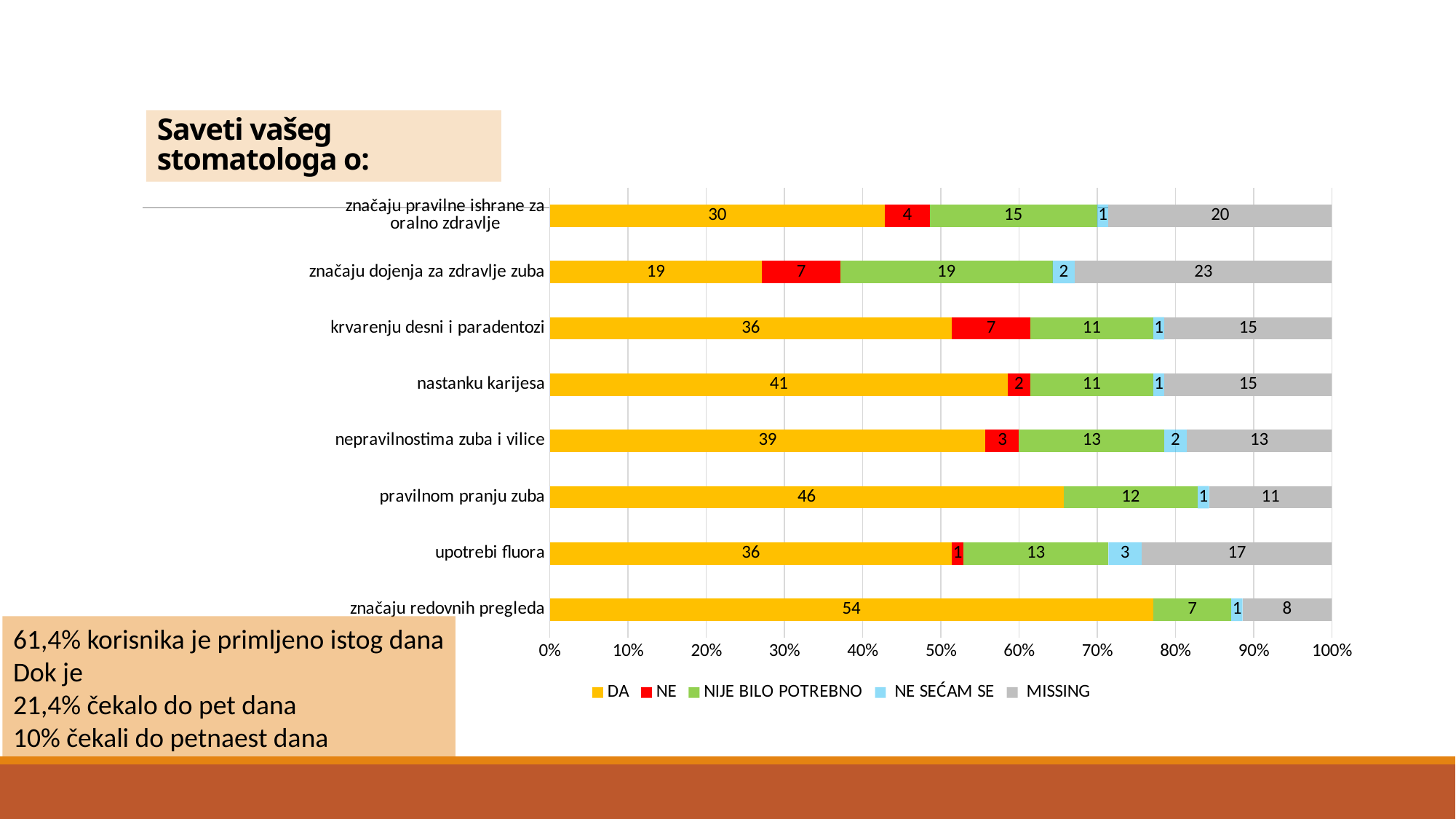
Which is larger, the NE value for 'krvarenju desni i paradentozi' or the NE value for 'nastanku karijesa'? krvarenju desni i paradentozi Does the DA segment for 'značaju redovnih pregleda' end at a share greater or less than 70%? greater Which category has the highest DA value? značaju redovnih pregleda Which category has the lowest DA value? značaju dojenja za zdravlje zuba What is the MISSING value for 'značaju dojenja za zdravlje zuba'? 23 How many series does the legend list? 5 What kind of chart is shown on the slide? stacked bar chart What is the NIJE BILO POTREBNO value for 'upotrebi fluora'? 13 How many categories are shown on the chart? 8 What is the DA value for 'nastanku karijesa'? 41 What is the total of all segments in the bar for 'značaju pravilne ishrane za oralno zdravlje'? 70 What is the difference between the DA values for 'pravilnom pranju zuba' and 'nepravilnostima zuba i vilice'? 7